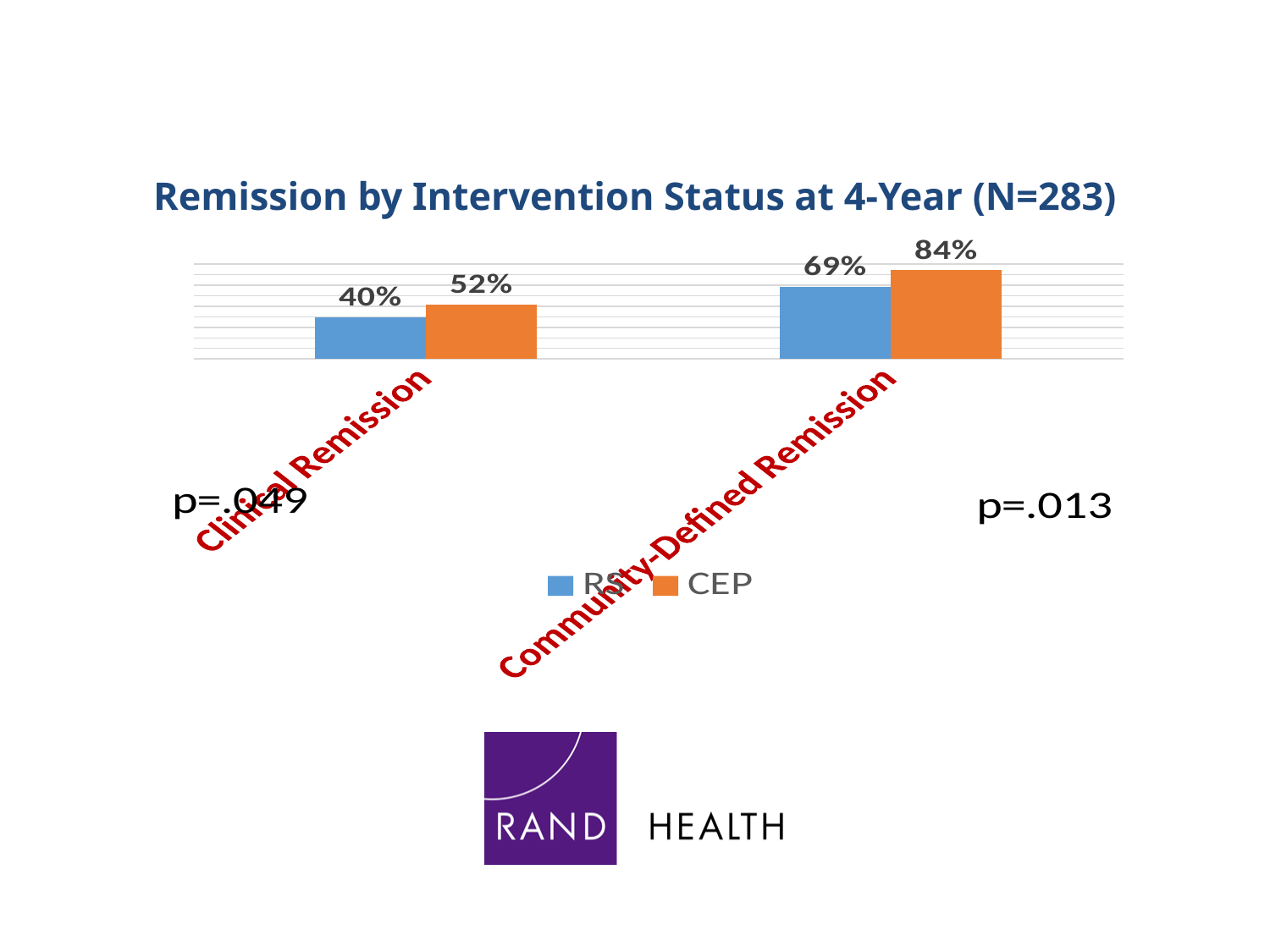
Which bar has the highest value on the chart? CEP, Community-Defined Remission What is the difference between the CEP and RS values for Community-Defined Remission? 15% Which bar has the lowest value on the chart? RS, Clinical Remission Which is larger for Clinical Remission, RS or CEP? CEP What is the CEP value for Clinical Remission? 52% What is the RS value for Community-Defined Remission? 69% What is the RS value for Clinical Remission? 40% How many categories are shown on the x axis? 2 What is the difference between the CEP and RS values for Clinical Remission? 12% What is the CEP value for Community-Defined Remission? 84% What kind of chart is shown on the slide? Bar chart How many series does the legend list? 2